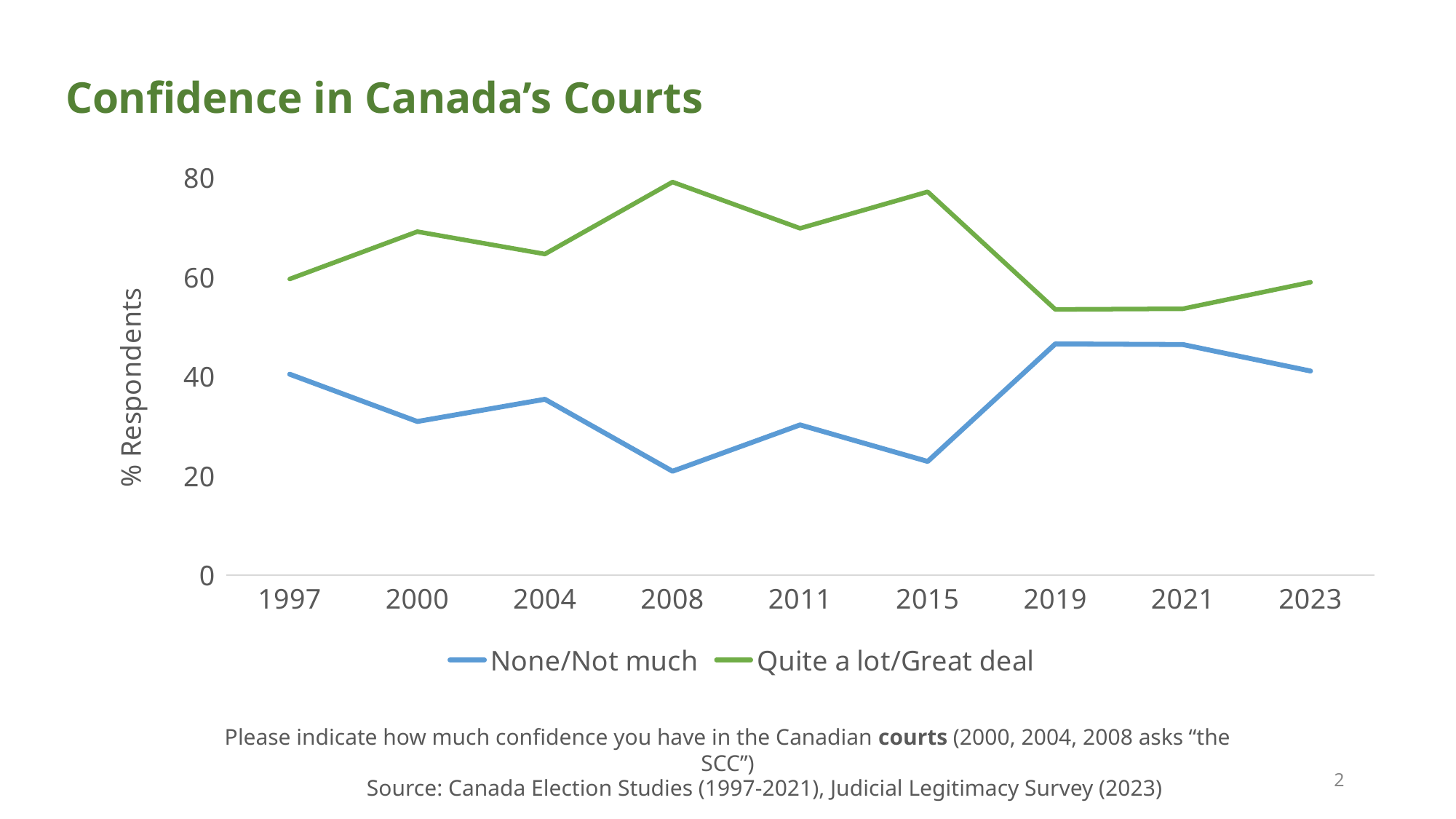
Does the None/Not much line rise or fall from 2015 to 2019? rise Is the value for None/Not much in 2000 greater or less than 40? less How many series does the legend list? 2 Does the Quite a lot/Great deal line rise or fall from 2015 to 2019? fall What is the label on the y axis? % Respondents How many years are plotted along the x axis? 9 What kind of chart is shown on the slide? line chart Is the value for Quite a lot/Great deal in 2008 greater or less than 60? greater Is the value for Quite a lot/Great deal in 2019 greater or less than 60? less For None/Not much, which year has the larger value, 2008 or 2019? 2019 In 2008, which series has the larger value, None/Not much or Quite a lot/Great deal? Quite a lot/Great deal